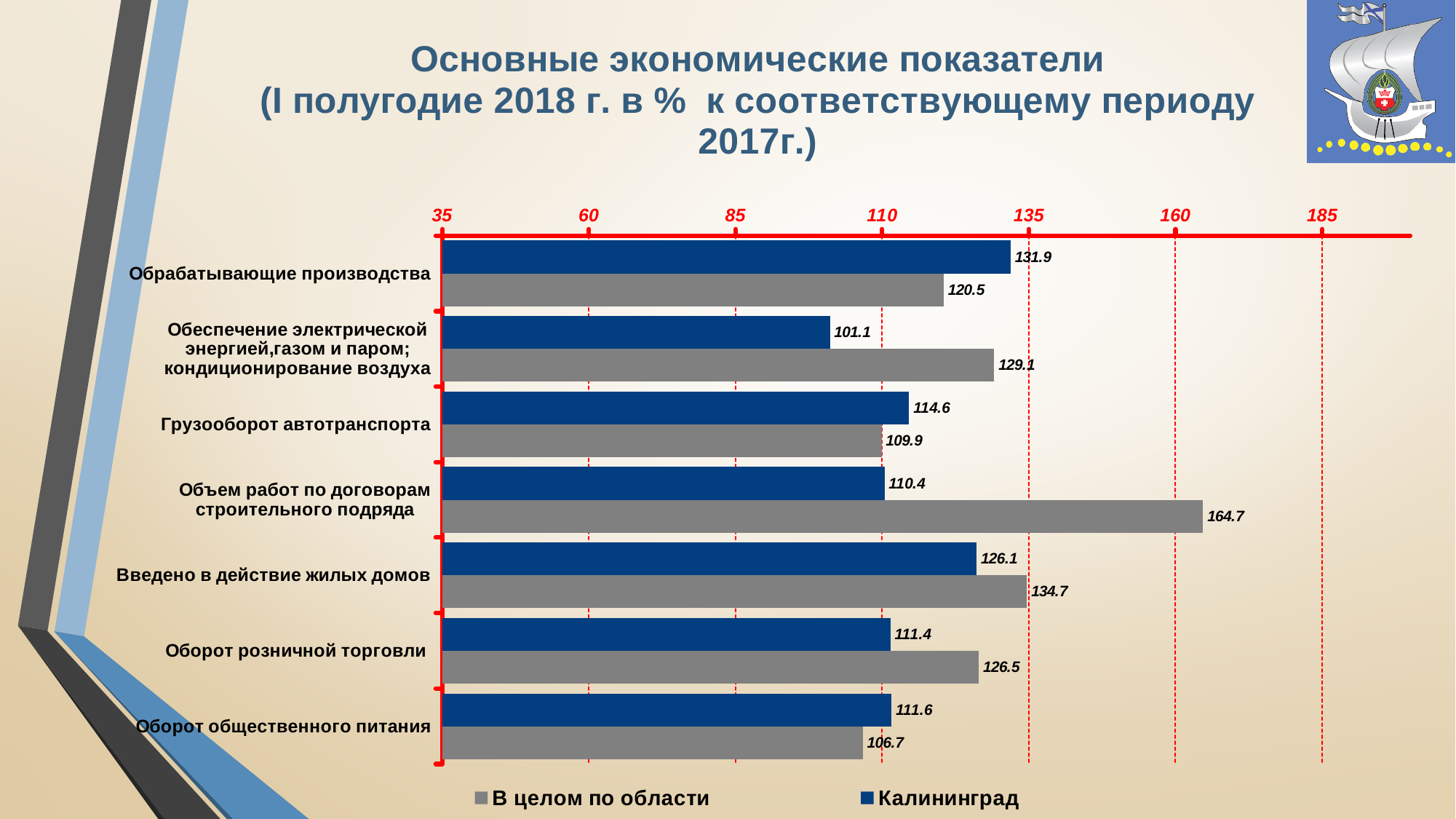
For Грузооборот автотранспорта, which is larger: the value for Калининград or for В целом по области? Калининград How many series does the legend list? 2 Which colour represents the series Калининград in the chart? blue Is the value for В целом по области for Оборот розничной торговли greater or less than 110? greater What is the difference between the В целом по области and Калининград values for Введено в действие жилых домов? 8.6 How many categories are shown on the chart? 7 Which category has the lowest value for Калининград? Обеспечение электрической энергией, газом и паром; кондиционирование воздуха What is the value for В целом по области for Объем работ по договорам строительного подряда? 164.7 What is the value for Калининград for Обрабатывающие производства? 131.9 What kind of chart is shown on the slide? bar chart What is the value for Калининград for Оборот общественного питания? 111.6 Which category has the highest value for В целом по области? Объем работ по договорам строительного подряда